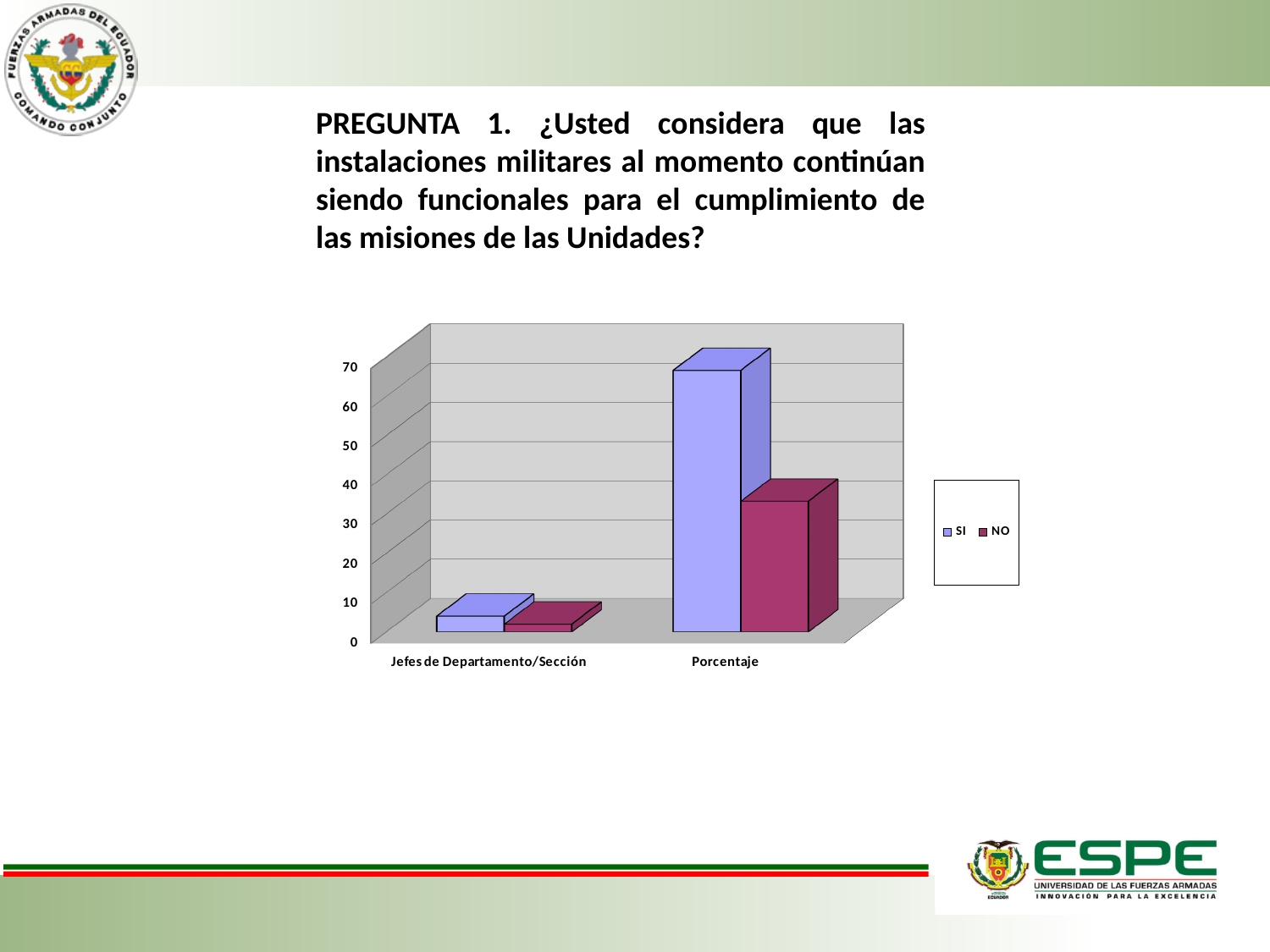
Which series is shown in blue? SI Is the NO value for Porcentaje greater or less than 20? greater Is the SI value for Porcentaje greater or less than 50? greater What are the two series named in the legend? SI and NO How many categories are shown on the x axis? 2 Which category has the shorter NO bar? Jefes de Departamento/Sección For Porcentaje, which is larger, SI or NO? SI Which category has the taller SI bar? Porcentaje What kind of chart is shown on the slide? bar chart How many series does the legend list? 2 Is the SI value for Jefes de Departamento/Sección greater or less than 10? less